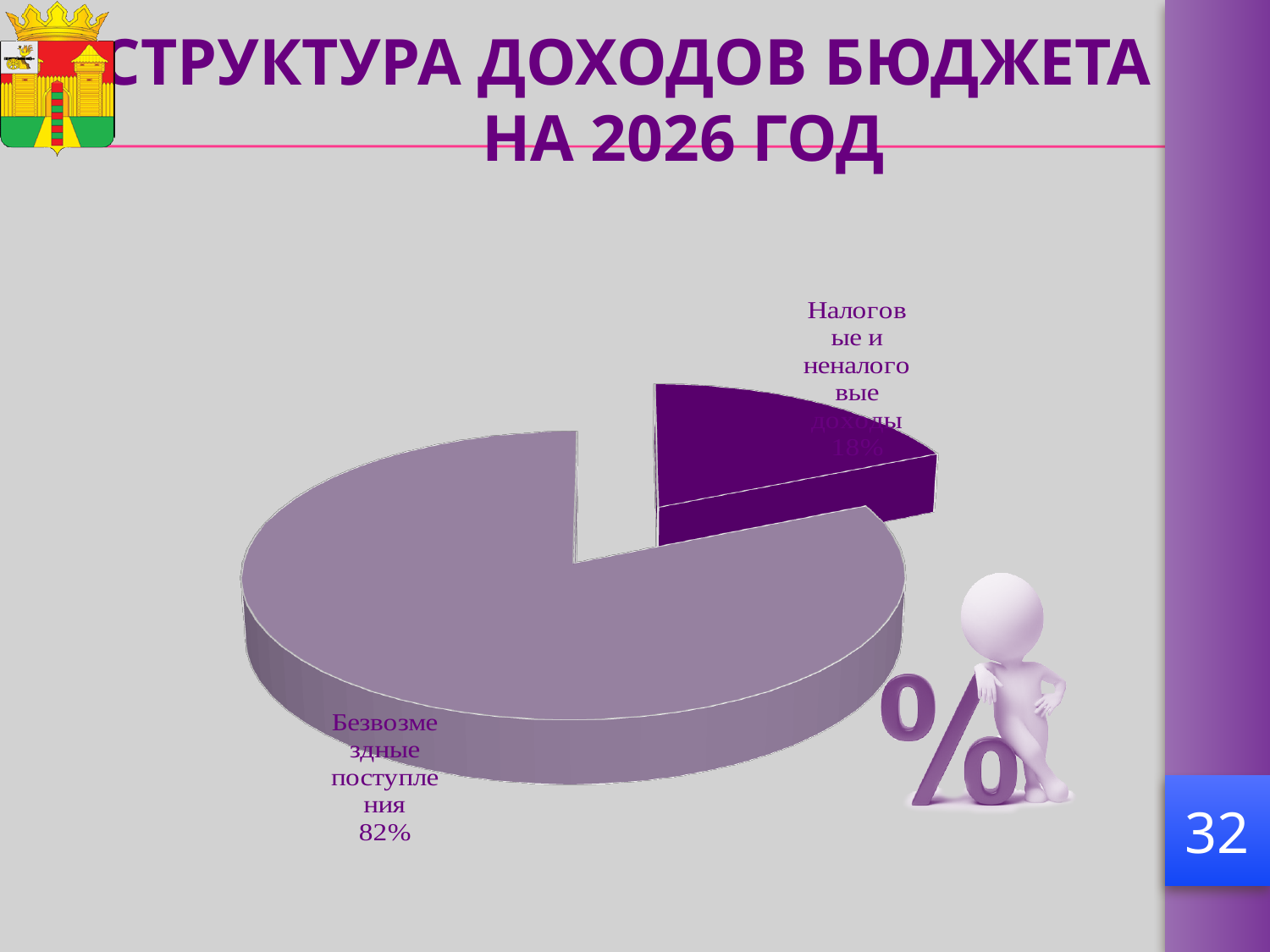
Is the share for "Налоговые и неналоговые доходы" greater or less than 25%? less Which slice of the pie chart is the smallest? Налоговые и неналоговые доходы Is the share for "Безвозмездные поступления" greater or less than 50%? greater What is the title of the chart on the slide? СТРУКТУРА ДОХОДОВ БЮДЖЕТА НА 2026 ГОД Which is larger: the share for "Безвозмездные поступления" or the share for "Налоговые и неналоговые доходы"? Безвозмездные поступления What share of the pie is labelled "Налоговые и неналоговые доходы"? 18% Which year does the chart title refer to? 2026 Which slice of the pie chart is the largest? Безвозмездные поступления What kind of chart is shown on the slide? pie chart How many slices does the pie chart have? 2 What share of the pie is labelled "Безвозмездные поступления"? 82% What is the difference in percentage points between the "Безвозмездные поступления" share and the "Налоговые и неналоговые доходы" share? 64